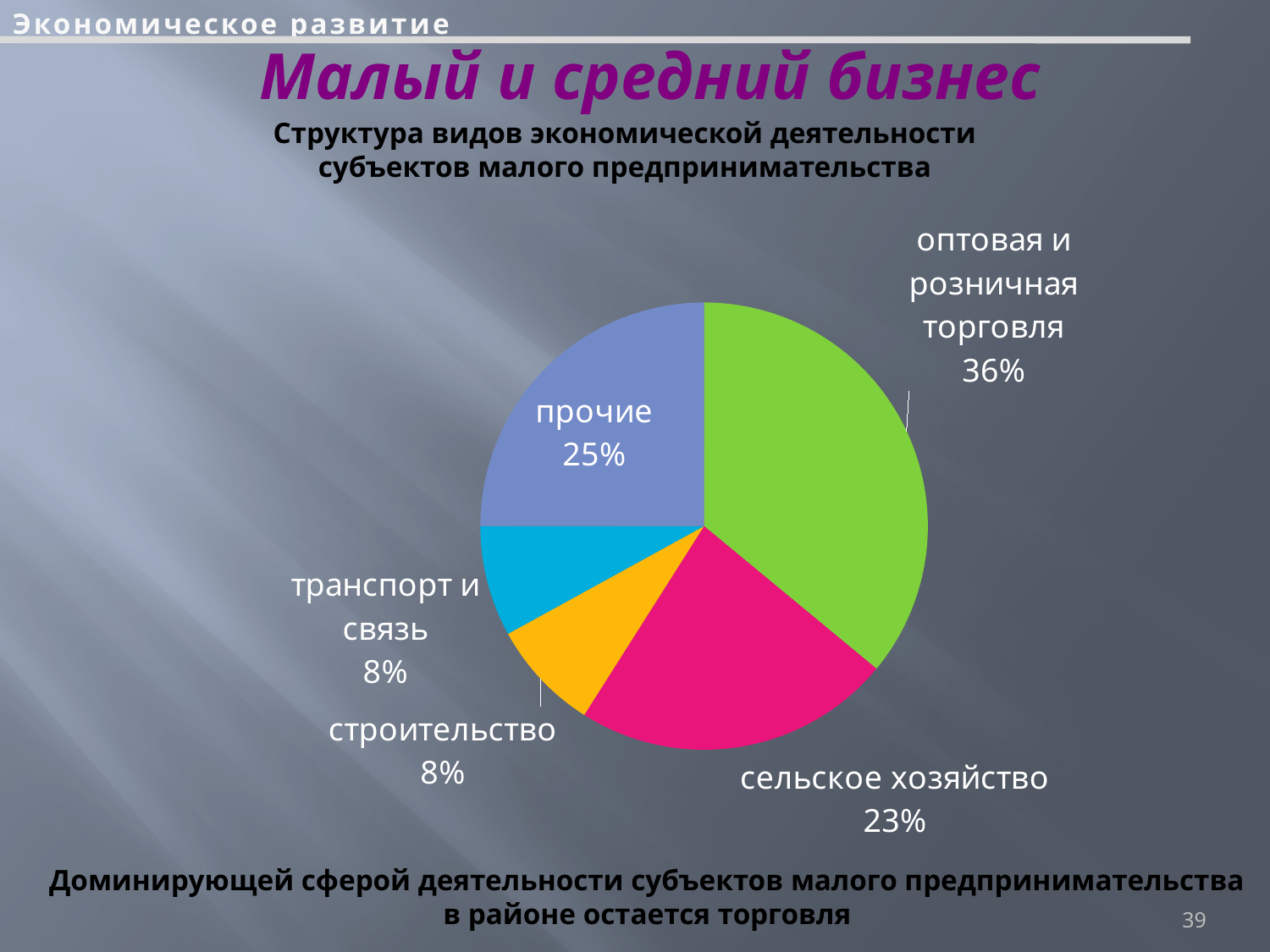
What is the title of the chart shown on the slide? Структура видов экономической деятельности субъектов малого предпринимательства How many slices does the pie chart have? 5 What kind of chart is shown on the slide? pie chart Which category has the largest share of the pie? оптовая и розничная торговля What is the difference in percentage points between "оптовая и розничная торговля" and "сельское хозяйство"? 13 What share of the pie does "транспорт и связь" have? 8% What is the difference in percentage points between "прочие" and "строительство"? 17 What share of the pie does "строительство" have? 8% What share of the pie does "оптовая и розничная торговля" have? 36% What share of the pie does "прочие" have? 25% Which is larger, the share for "прочие" or the share for "сельское хозяйство"? прочие What share of the pie does "сельское хозяйство" have? 23%